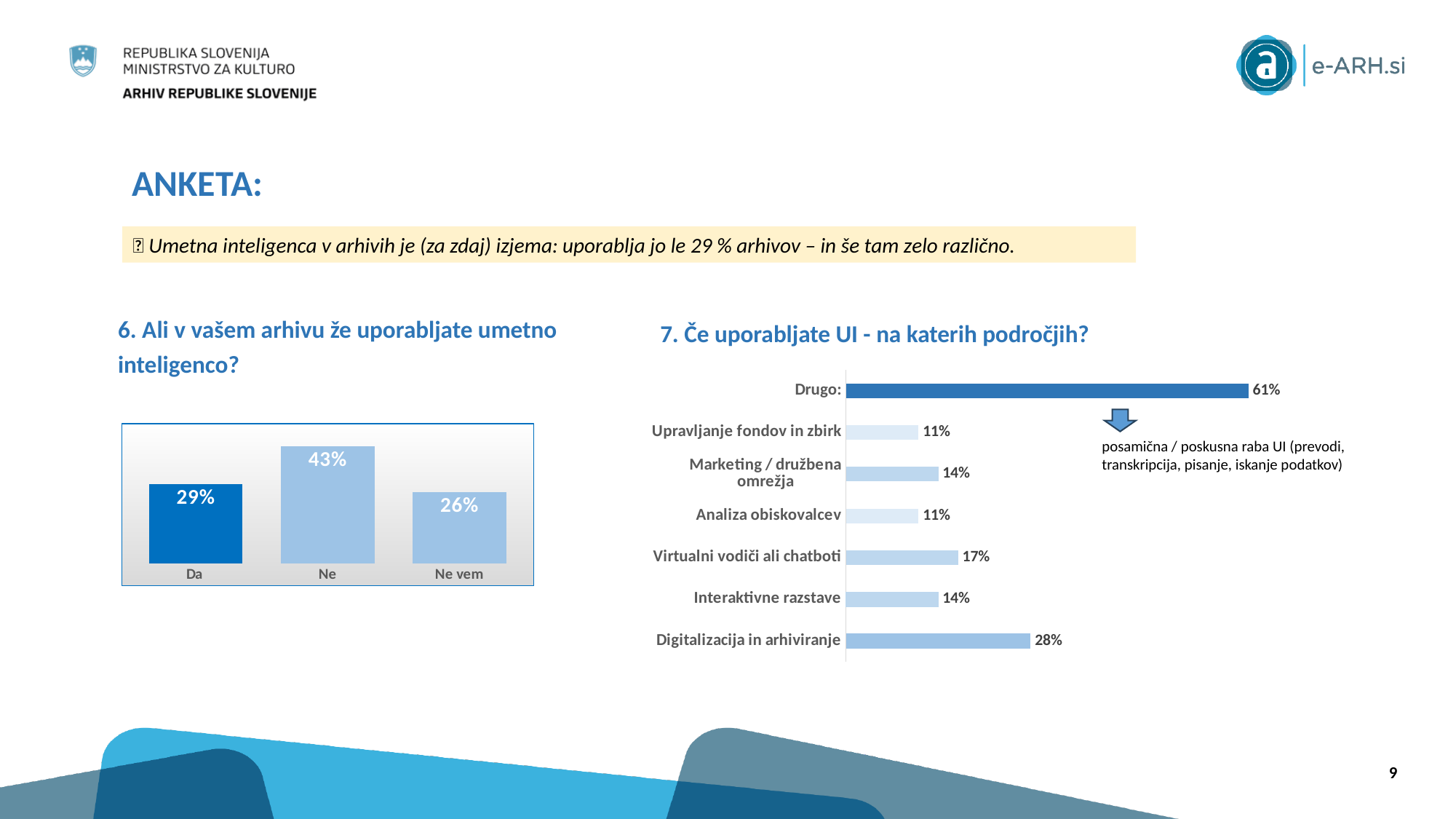
In the right chart (question 7), which category has the highest value? Drugo: In the left chart (question 6), what is the difference between the values for "Ne" and "Da"? 14% In the left chart (question 6), which category has the lowest value? Ne vem In the right chart (question 7), what is the value for "Virtualni vodiči ali chatboti"? 17% In the right chart (question 7), which is larger: "Marketing / družbena omrežja" or "Analiza obiskovalcev"? Marketing / družbena omrežja In the right chart (question 7), how many categories are shown? 7 In the left chart (question 6), which category has the highest value? Ne In the right chart (question 7), what is the value for "Digitalizacija in arhiviranje"? 28% What type of chart is the right chart (question 7)? Bar chart In the left chart (question 6), how many categories are shown? 3 In the right chart (question 7), what is the difference between "Drugo:" and "Digitalizacija in arhiviranje"? 33% In the left chart (question 6), what is the value for "Da"? 29%